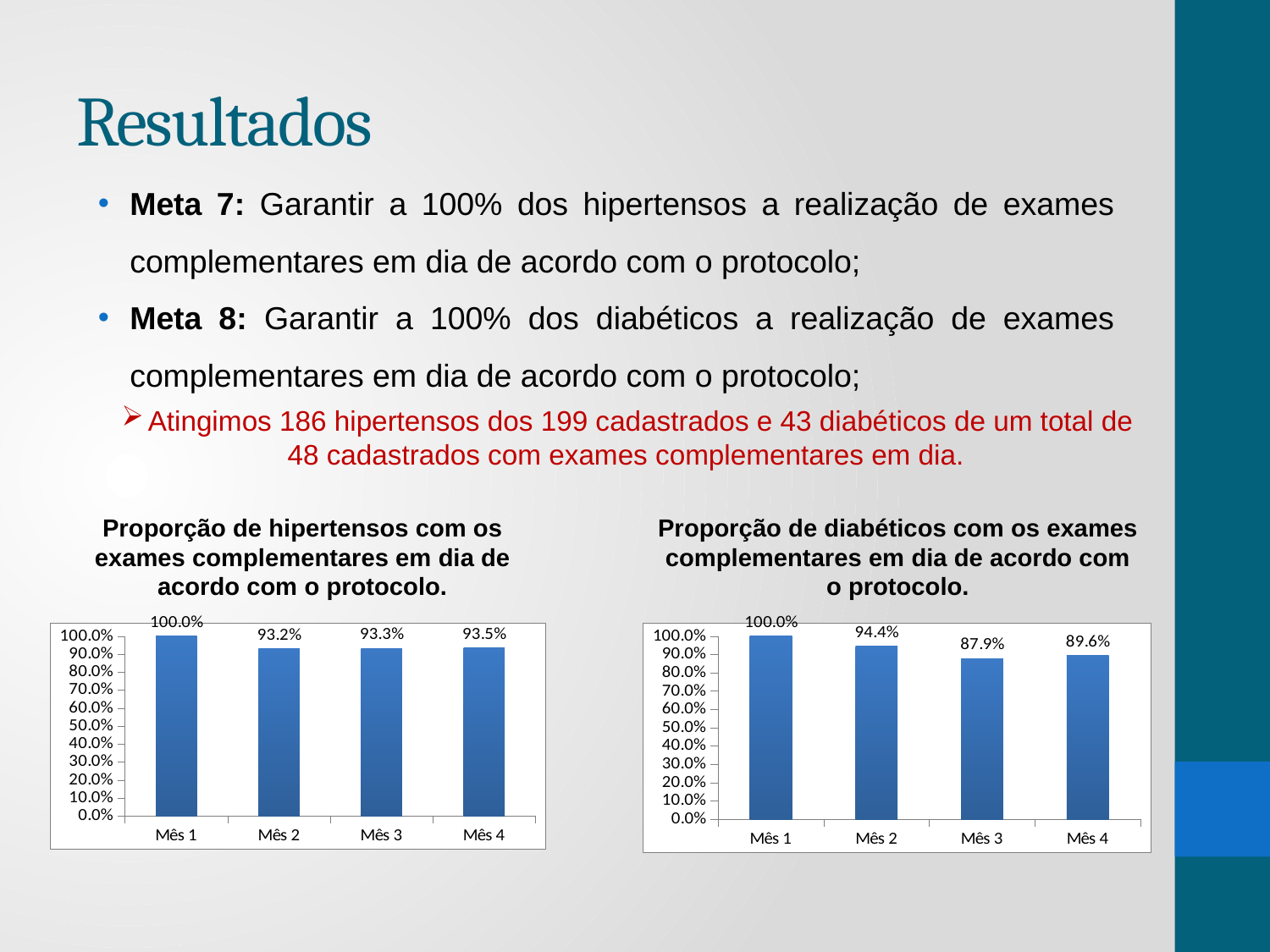
What is the title of the left chart? Proporção de hipertensos com os exames complementares em dia de acordo com o protocolo. In the left chart (Proporção de hipertensos), what is the difference between the values for Mês 4 and Mês 2? 0.3% What kind of chart is the right chart (Proporção de diabéticos)? Bar chart In the left chart (Proporção de hipertensos), which month has the highest value? Mês 1 In the right chart (Proporção de diabéticos), is the value for Mês 3 greater or less than 90.0%? less In the right chart (Proporção de diabéticos com os exames complementares em dia de acordo com o protocolo), what is the value for Mês 3? 87.9% In the left chart (Proporção de hipertensos com os exames complementares em dia de acordo com o protocolo), what is the value for Mês 2? 93.2% How many months (categories) are shown in the left chart (Proporção de hipertensos)? 4 In the right chart (Proporção de diabéticos), which month has the lowest value? Mês 3 In the right chart (Proporção de diabéticos), what is the difference between the values for Mês 1 and Mês 2? 5.6% In the right chart (Proporção de diabéticos), which is larger, the value for Mês 2 or the value for Mês 4? Mês 2 In the right chart (Proporção de diabéticos), what is the value for Mês 4? 89.6%